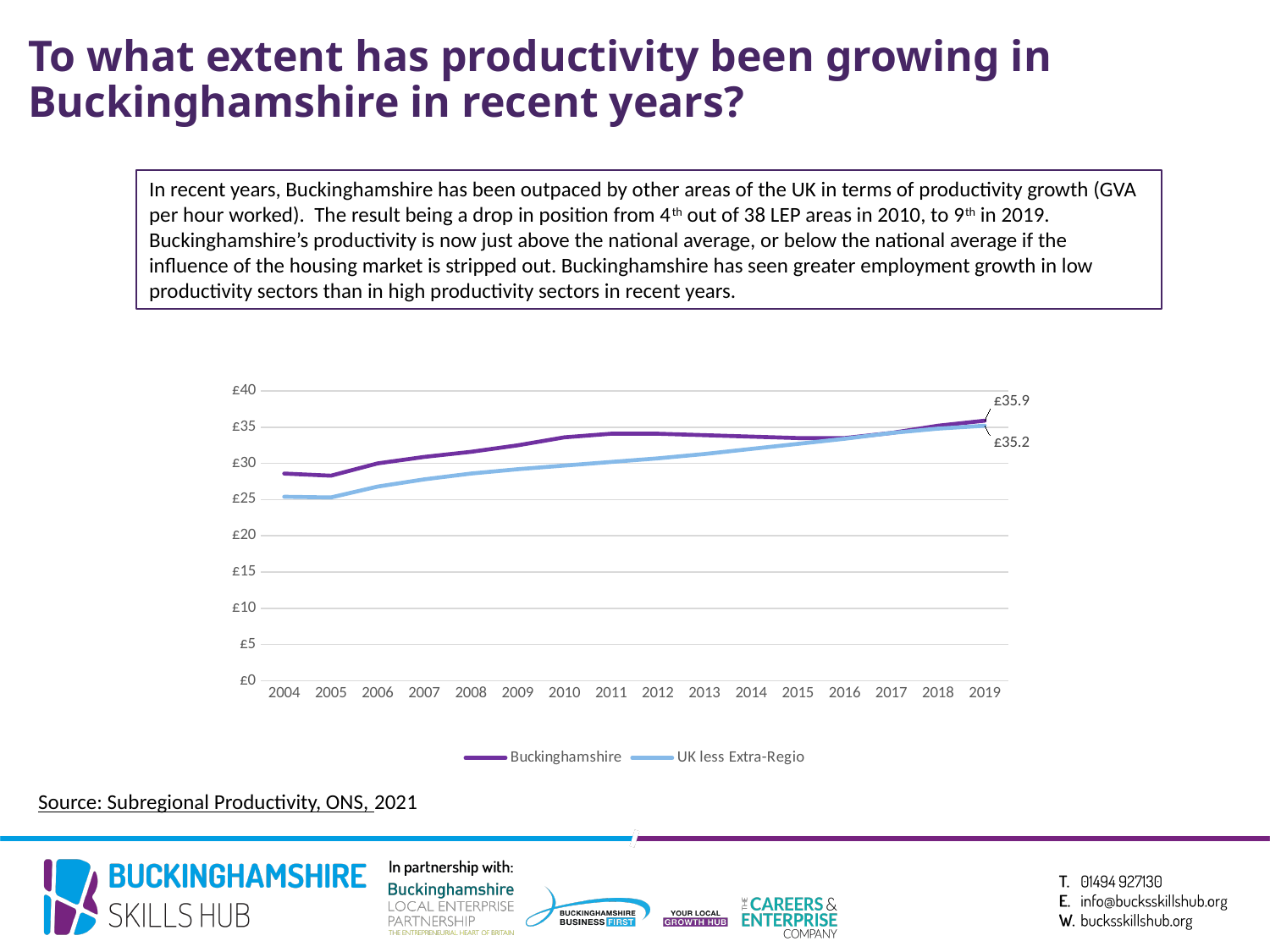
In 2019, which series has the higher value, Buckinghamshire or UK less Extra-Regio? Buckinghamshire In which year does the Buckinghamshire series reach its highest value? 2019 What is the value for Buckinghamshire in 2019? £35.9 What is the value for UK less Extra-Regio in 2019? £35.2 Is the value for UK less Extra-Regio in 2004 greater or less than £20? greater Is the value for Buckinghamshire in 2004 greater or less than £30? less What is the difference between the Buckinghamshire and UK less Extra-Regio values in 2019? £0.7 In 2010, which series has the higher value, Buckinghamshire or UK less Extra-Regio? Buckinghamshire How many years are shown along the x axis of the chart? 16 How many series does the chart legend list? 2 Does the UK less Extra-Regio series rise or fall from 2004 to 2019? rise What kind of chart is shown on the slide? line chart